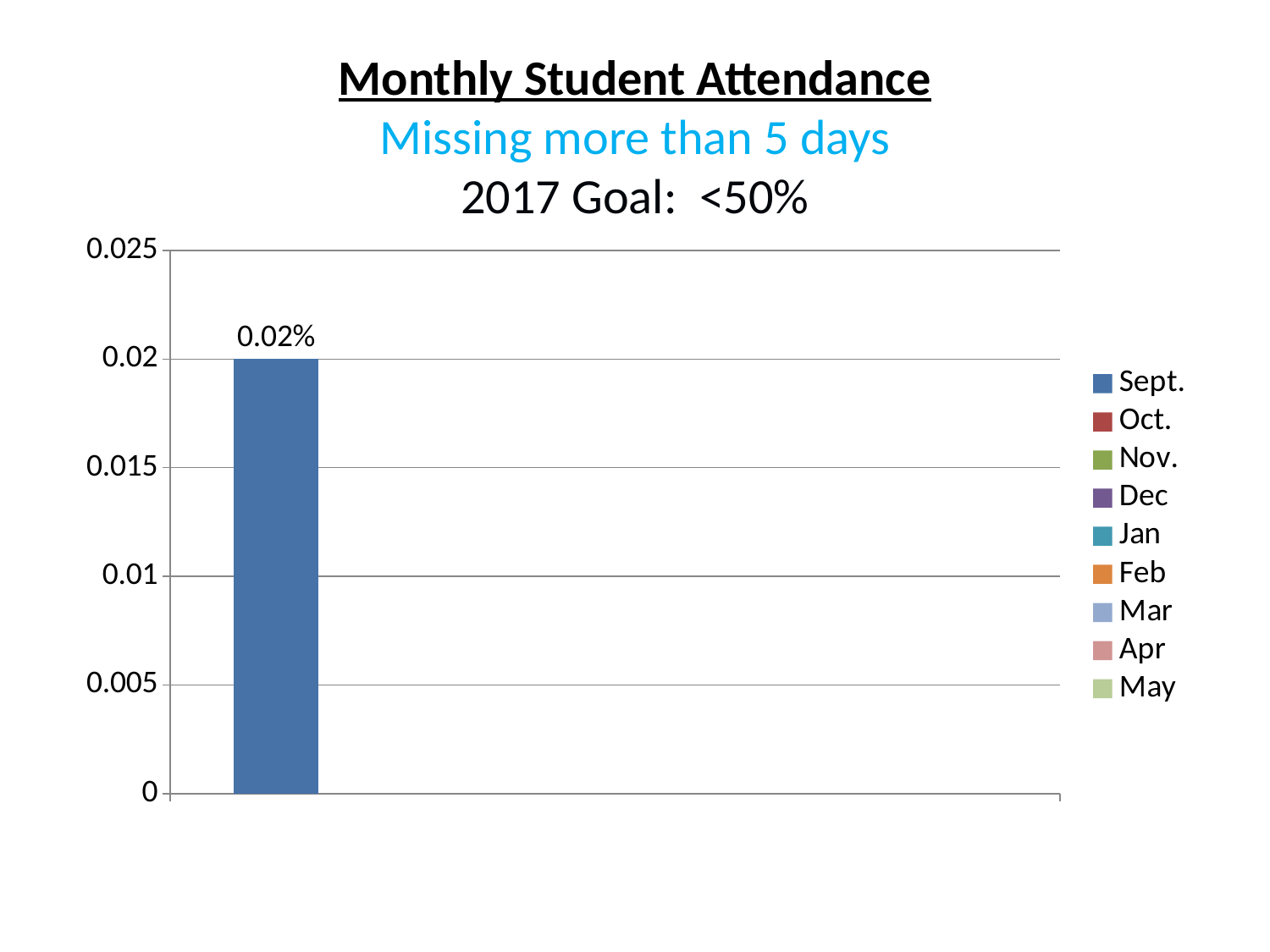
What is the highest value shown on the vertical axis? 0.025 Which month is the only one with a bar plotted in the chart? Sept. Is the value for Sept. greater or less than 0.01 on the axis? greater What value is shown for Sept. in the chart? 0.02% How many series does the chart legend list? 9 What is the first entry in the chart legend? Sept. Is the value for Sept. greater or less than 0.025 on the axis? less What kind of chart is shown on the slide? Bar chart How many bars are actually plotted in the chart? 1 What is the last entry in the chart legend? May